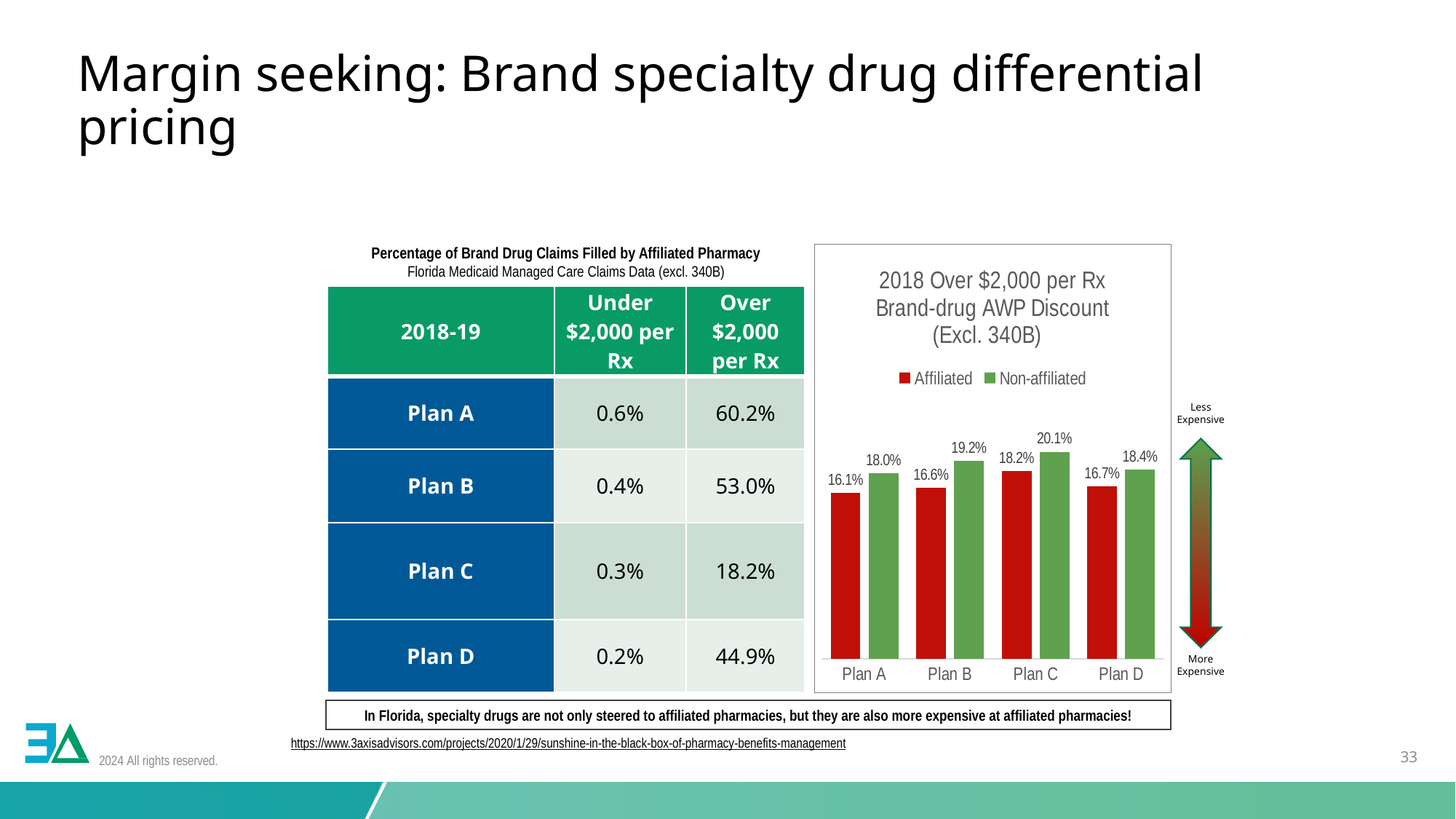
Which plan has the lowest Non-affiliated value in the bar chart? Plan A What is the Affiliated value for Plan D in the bar chart? 16.7% What is the Non-affiliated value for Plan B in the bar chart? 19.2% In the bar chart, is the Affiliated or the Non-affiliated value larger for Plan D? Non-affiliated How many series does the legend of the bar chart list? 2 What is the Affiliated value for Plan A in the bar chart? 16.1% In the bar chart, what is the difference between the Non-affiliated and Affiliated values for Plan B? 2.6 percentage points How many plans are shown on the x axis of the bar chart? 4 What kind of chart is shown on the right of the slide? Bar chart What is the Non-affiliated value for Plan C in the bar chart? 20.1% What colour are the Affiliated bars in the chart? Red Which plan has the highest Affiliated value in the bar chart? Plan C